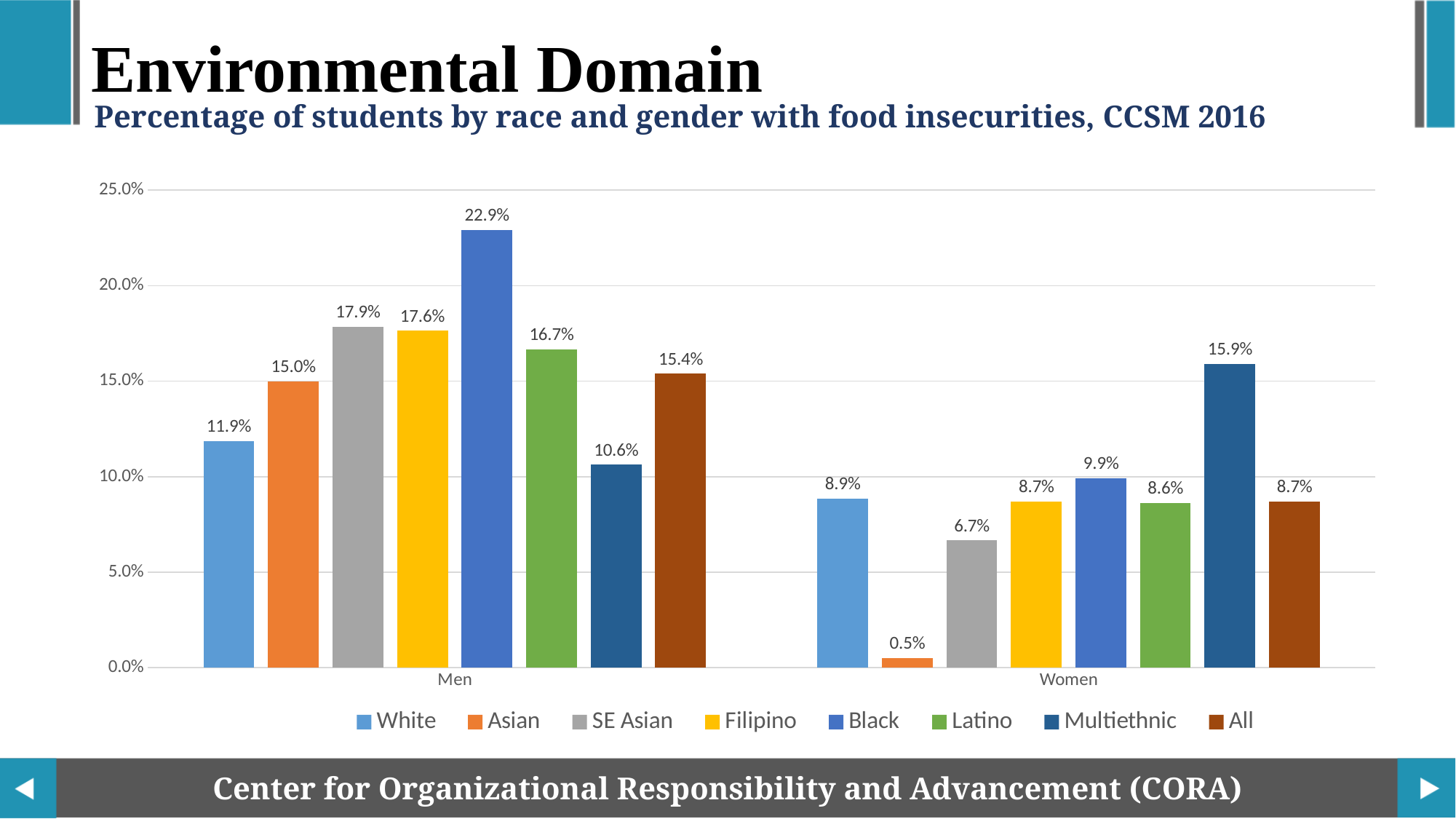
What is the difference between the All value for Men and the All value for Women? 6.7% What kind of chart is shown on the slide? Bar chart Which series has the lowest value among Women? Asian What is the difference between the Black men value and the Black women value? 13.0% How many series does the legend list? 8 Which is larger: the value for SE Asian men or Filipino men? SE Asian men What percentage of Black men reported food insecurities? 22.9% What is the value for Asian women? 0.5% What is the value for the All series in the Men category? 15.4% What is the value for Multiethnic women? 15.9% How many categories are shown on the x axis? 2 Which series has the highest value among Men? Black